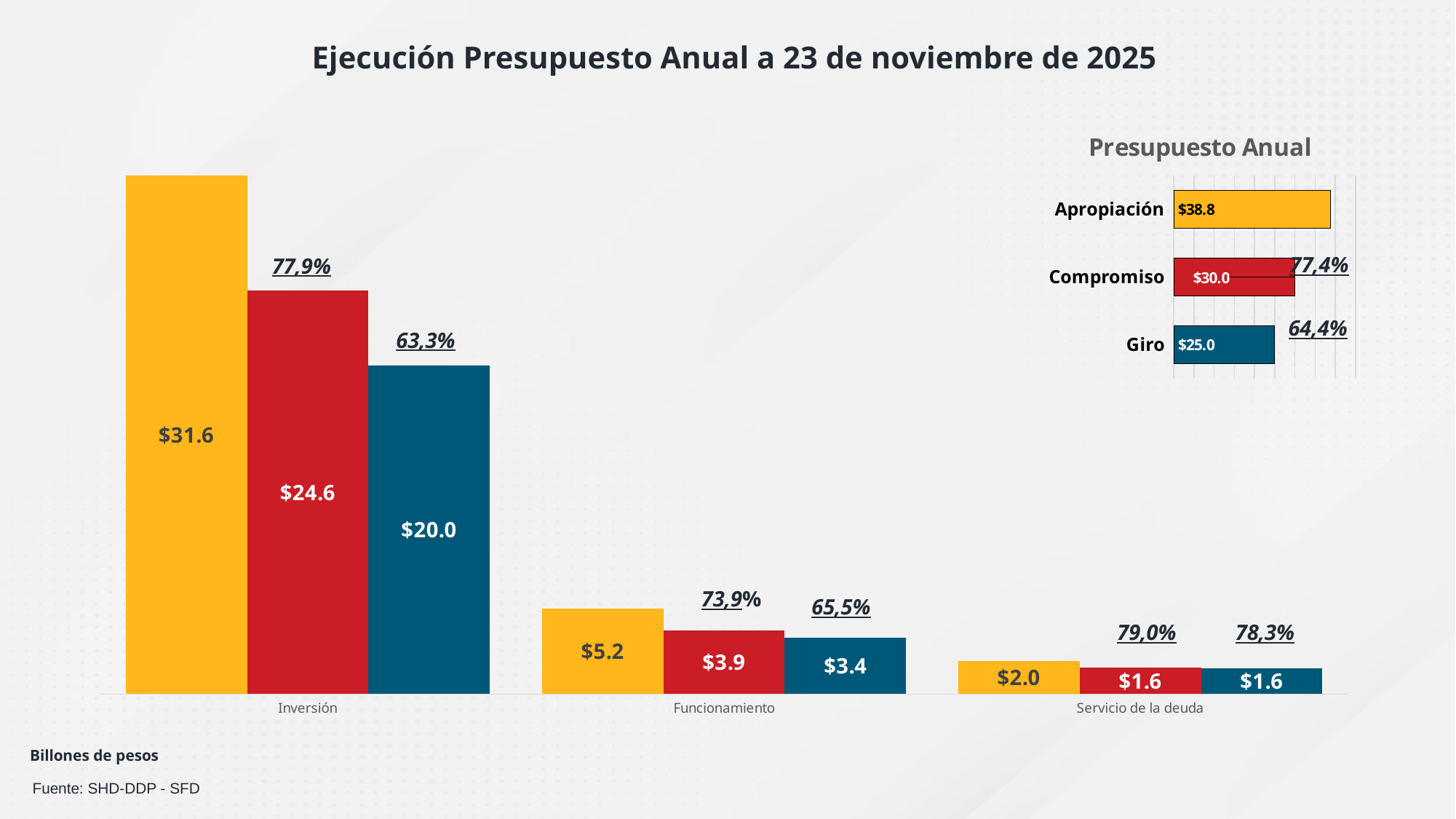
In the main chart 'Ejecución Presupuesto Anual a 23 de noviembre de 2025', what is the value of the blue bar for Funcionamiento? $3.4 In the main chart 'Ejecución Presupuesto Anual a 23 de noviembre de 2025', what percentage is shown above the red bar for Servicio de la deuda? 79,0% In the main chart 'Ejecución Presupuesto Anual a 23 de noviembre de 2025', what is the difference between the yellow bar and the red bar for Inversión? $7.0 What type of chart is the 'Presupuesto Anual' chart? Bar chart In the 'Presupuesto Anual' chart, which category has the lowest value? Giro In the 'Presupuesto Anual' chart, what is the value for Giro? $25.0 In the main chart 'Ejecución Presupuesto Anual a 23 de noviembre de 2025', how many categories are shown on the x axis? 3 In the main chart 'Ejecución Presupuesto Anual a 23 de noviembre de 2025', what is the value of the yellow bar for Inversión? $31.6 In the main chart 'Ejecución Presupuesto Anual a 23 de noviembre de 2025', which category has the highest yellow bar? Inversión In the 'Presupuesto Anual' chart, what percentage is shown next to the Compromiso bar? 77,4% In the 'Presupuesto Anual' chart, what is the value for Apropiación? $38.8 In the 'Presupuesto Anual' chart, what is the difference between Apropiación and Compromiso? $8.8